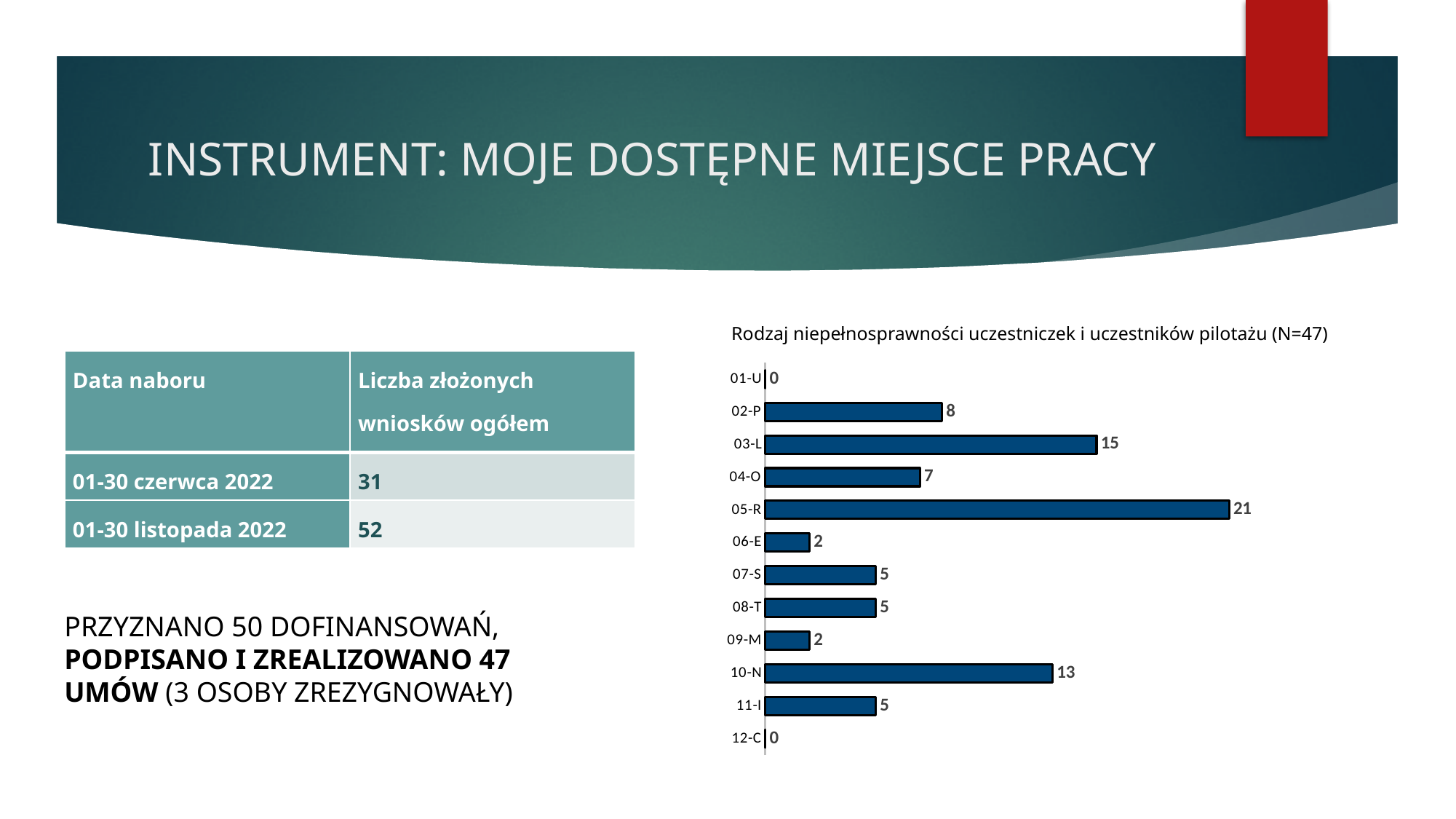
How many categories in the chart have a value of 0? 2 What is the value for 08-T in the chart? 5 What is the difference between the values for 05-R and 06-E? 19 What is the title of the chart? Rodzaj niepełnosprawności uczestniczek i uczestników pilotażu (N=47) Which category has the highest value in the chart? 05-R What is the value for 05-R in the chart? 21 What is the difference between the values for 03-L and 02-P? 7 What kind of chart is shown on the slide? bar chart What is the value for 04-O in the chart? 7 How many categories are shown in the chart? 12 What is the value for 10-N in the chart? 13 Which is larger, the value for 10-N or the value for 03-L? 03-L